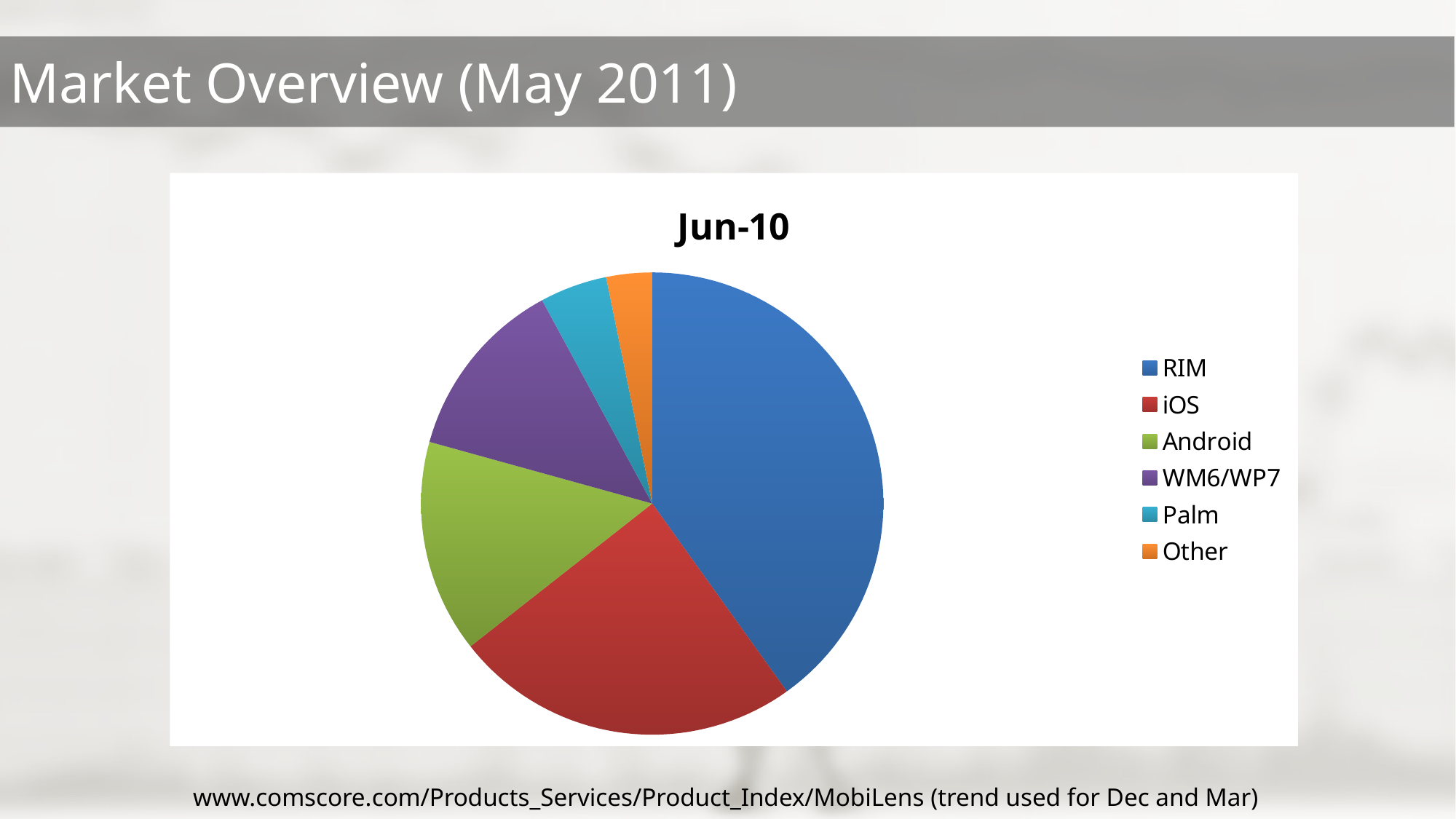
How many categories does the legend of the pie chart list? 6 Which category has the smallest slice of the pie chart? Other Which slice is larger in the pie chart, iOS or Android? iOS Which slice is larger in the pie chart, Android or WM6/WP7? Android Which category is shown in blue in the pie chart? RIM What is the title of the pie chart? Jun-10 Which slice is larger in the pie chart, Android or Palm? Android Which category has the largest slice of the pie chart? RIM What kind of chart is shown on the slide? Pie chart